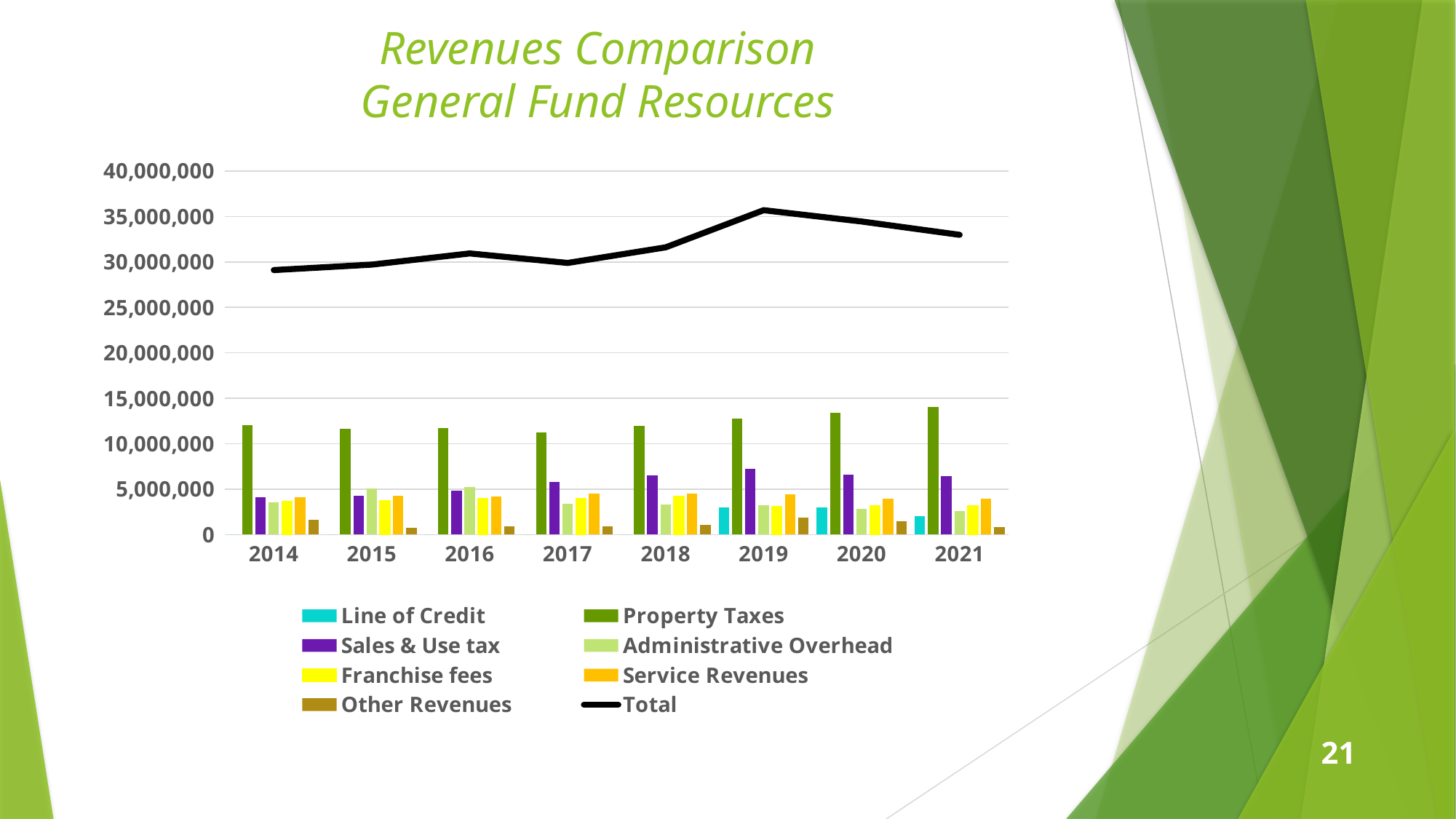
In which year does the Total line reach its highest point? 2019 Is the Property Taxes value for 2021 greater or less than 15,000,000? less In which year is the Sales & Use tax bar the tallest? 2019 Is the Total value for 2014 greater or less than 30,000,000? less How many series does the chart's legend list? 8 What is the title of the chart on the slide? Revenues Comparison General Fund Resources Is the Total value for 2019 greater or less than 35,000,000? greater In which year is the Total line at its lowest? 2014 What kind of chart is shown on the slide? A combination bar and line chart In 2014, which is larger: Property Taxes or Sales & Use tax? Property Taxes How many years are shown on the x axis of the chart? 8 Does the Total line rise or fall from 2019 to 2021? Falls